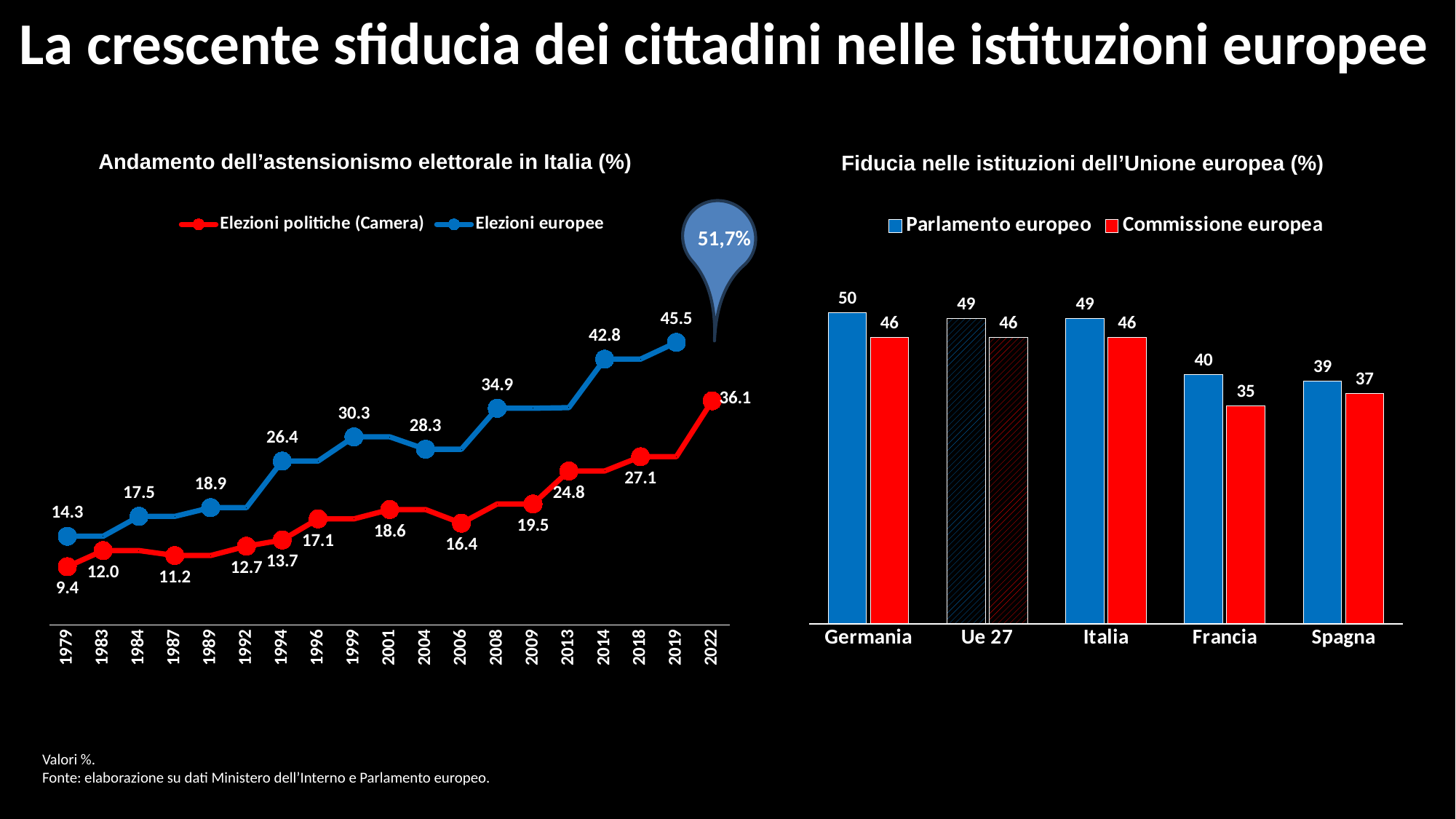
In the chart 'Andamento dell'astensionismo elettorale in Italia (%)', what is the difference between the Elezioni politiche (Camera) values in 2022 and 2018? 9.0 In the chart 'Andamento dell'astensionismo elettorale in Italia (%)', what is the value for Elezioni politiche (Camera) in 1979? 9.4 In the chart 'Fiducia nelle istituzioni dell'Unione europea (%)', what is the value for Commissione europea in Francia? 35 In the chart 'Fiducia nelle istituzioni dell'Unione europea (%)', how many series does the legend list? 2 In the chart 'Andamento dell'astensionismo elettorale in Italia (%)', what is the value for Elezioni europee in 2019? 45.5 In the chart 'Fiducia nelle istituzioni dell'Unione europea (%)', how many countries or groups are shown on the x axis? 5 What kind of chart is 'Fiducia nelle istituzioni dell'Unione europea (%)'? Bar chart In the chart 'Fiducia nelle istituzioni dell'Unione europea (%)', what is the value for Parlamento europeo in Germania? 50 In the chart 'Andamento dell'astensionismo elettorale in Italia (%)', do the Elezioni europee values generally rise or fall from 1979 to 2019? Rise In the chart 'Fiducia nelle istituzioni dell'Unione europea (%)', which country has the lowest value for Parlamento europeo? Spagna In the chart 'Andamento dell'astensionismo elettorale in Italia (%)', which is larger: Elezioni europee in 2014 or Elezioni politiche (Camera) in 2022? Elezioni europee in 2014 In the chart 'Fiducia nelle istituzioni dell'Unione europea (%)', what is the difference between Parlamento europeo and Commissione europea in Francia? 5